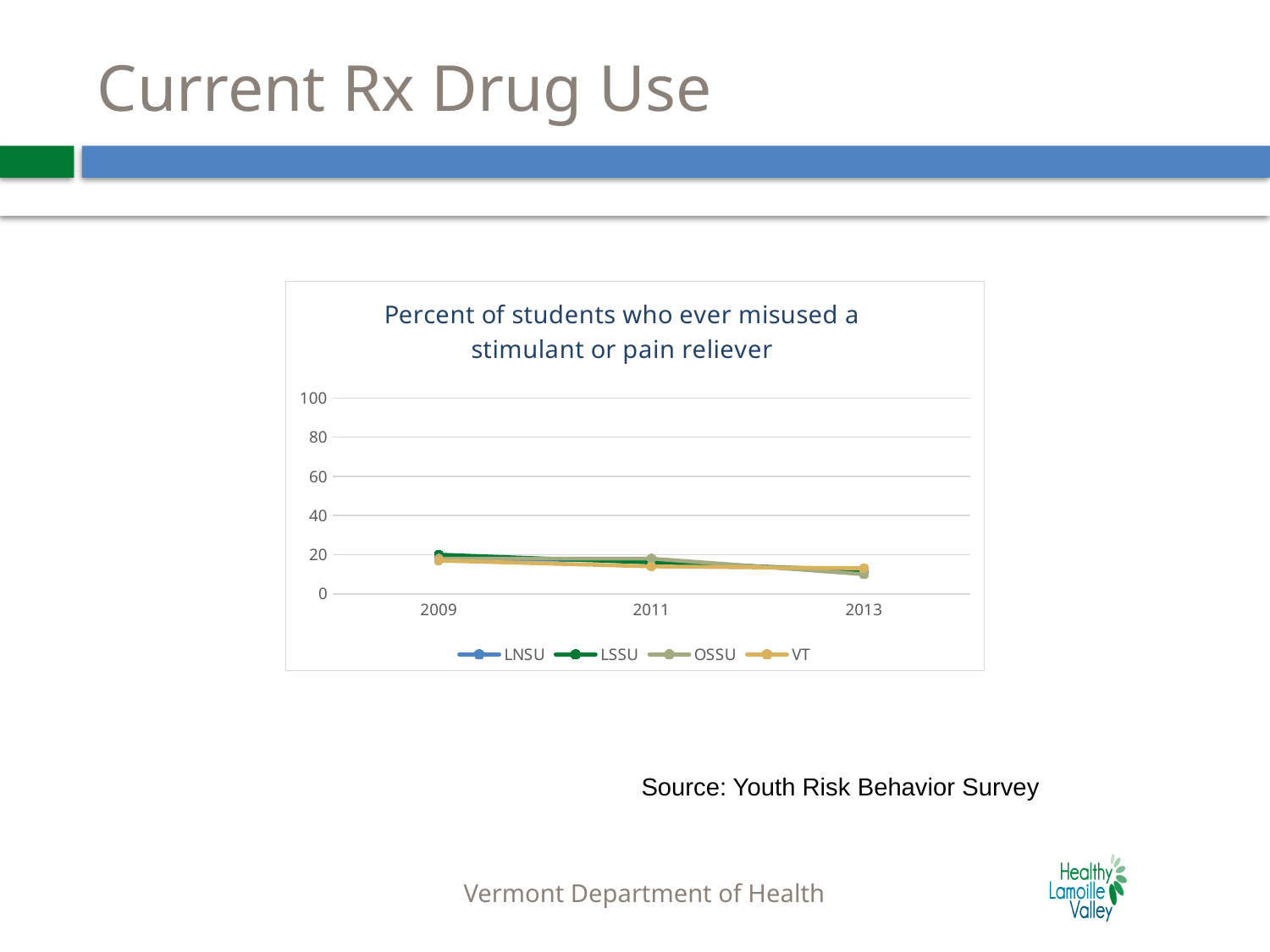
What kind of chart is shown on the slide? line chart Overall, do the plotted values rise or fall from 2009 to 2013? fall How many years are shown on the x axis? 3 Which series are listed in the legend? LNSU, LSSU, OSSU, VT Is the value for LSSU in 2013 greater or less than 20? less What is the title of the chart? Percent of students who ever misused a stimulant or pain reliever How many series does the legend list? 4 What is the first year shown on the x axis? 2009 Is the value for VT in 2013 greater or less than 20? less Is the value for LSSU in 2009 greater or less than 40? less Do the values for LSSU rise or fall from 2009 to 2013? fall